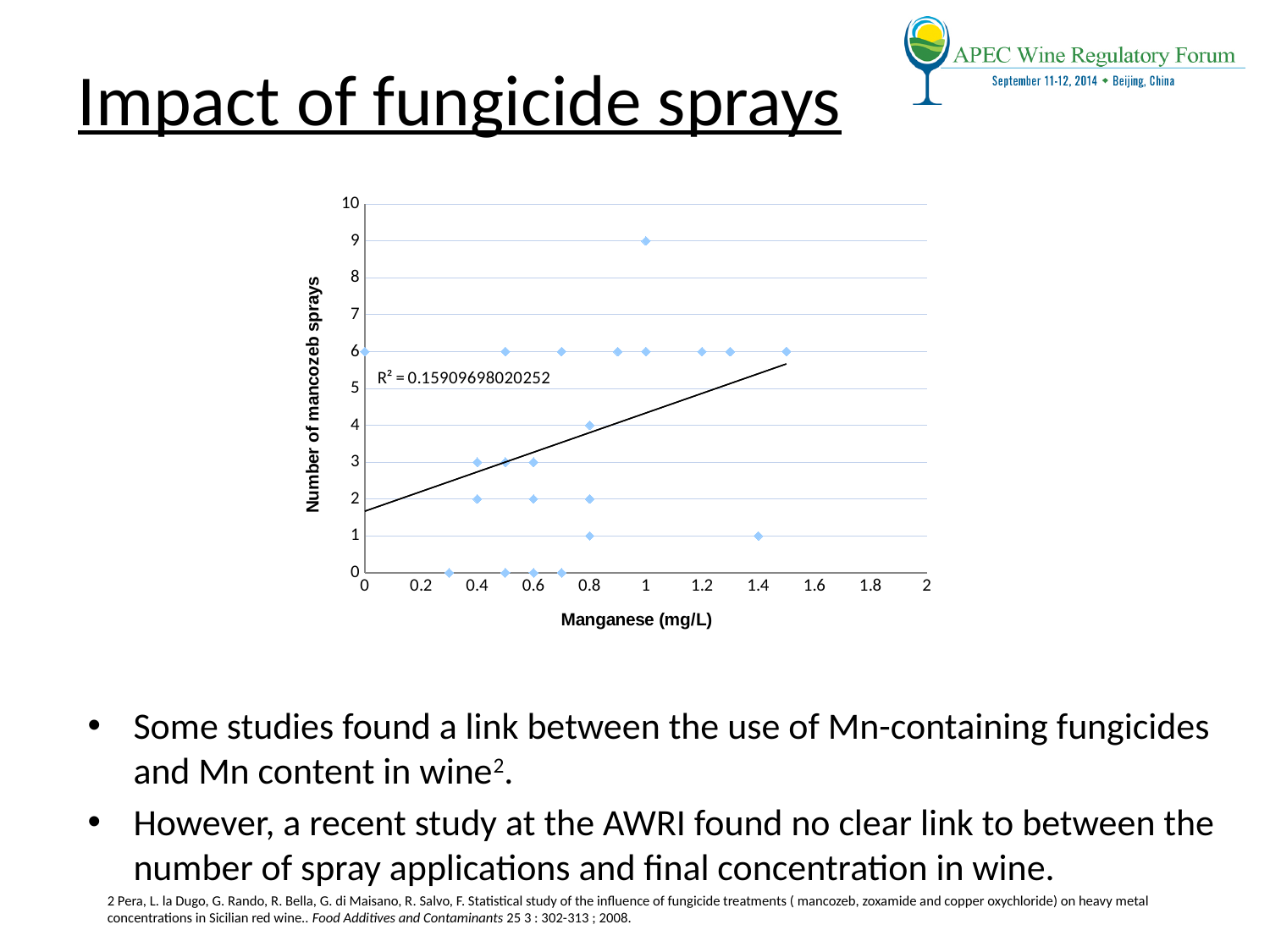
What R² value is printed on the chart? 0.15909698020252 What is the maximum value shown on the y axis of the chart? 10 What kind of chart is shown on the slide? scatter plot At what manganese concentration (mg/L) is the point with 9 mancozeb sprays plotted? 1 How many mancozeb sprays are plotted for the point at 0 mg/L manganese? 6 What is the maximum value shown on the x axis of the chart? 2 How many mancozeb sprays are plotted for the point at 1.4 mg/L manganese? 1 What is the title of the y axis of the chart? Number of mancozeb sprays Is the number of sprays for the point at 1.4 mg/L manganese greater or less than 4? less What is the title of the x axis of the chart? Manganese (mg/L) What is the highest number of mancozeb sprays plotted on the chart? 9 Does the fitted trendline rise or fall as manganese concentration increases? rises